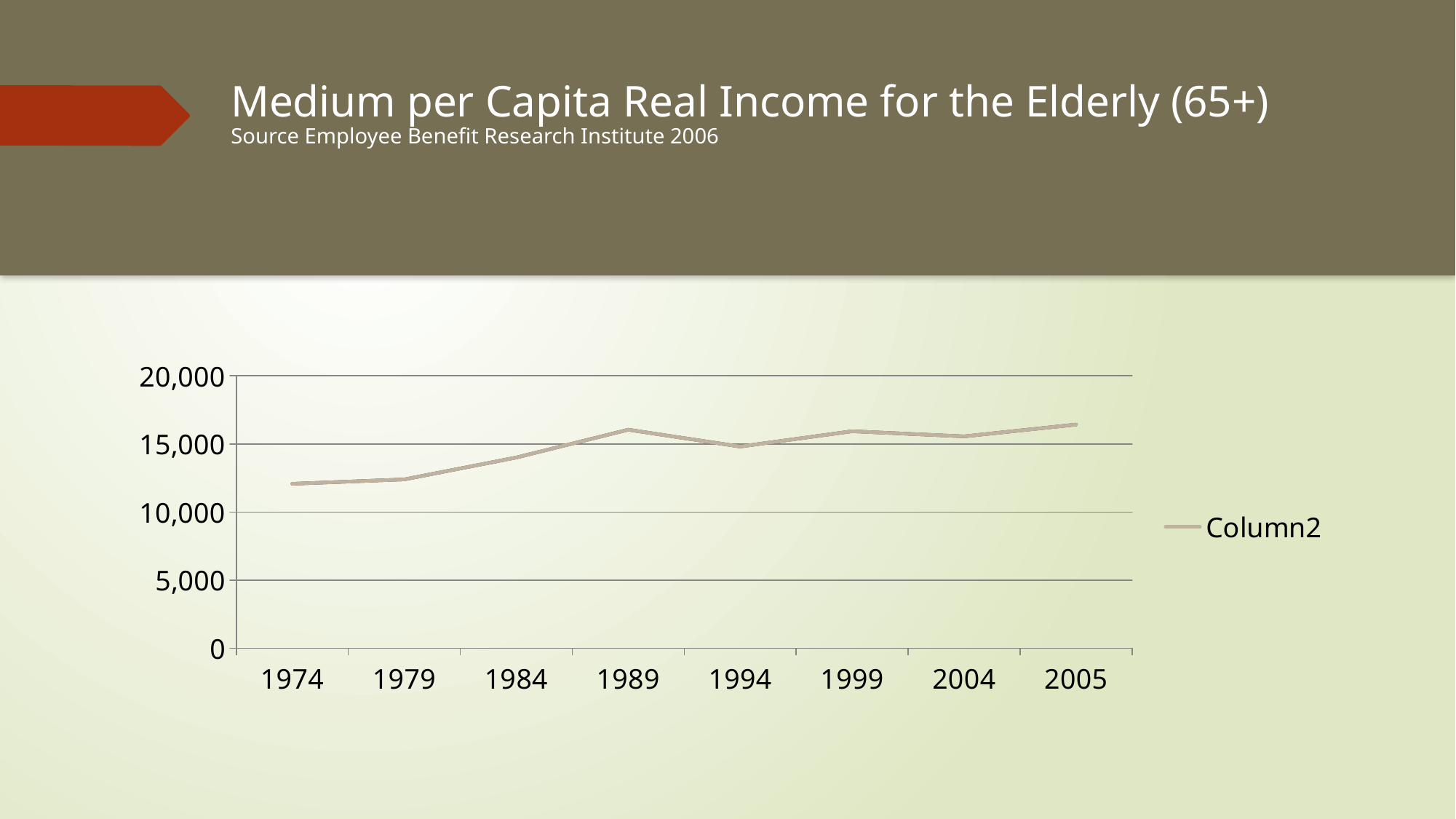
What is the name of the series shown in the legend? Column2 Overall, do the values rise or fall from 1974 to 2005? rise What kind of chart is shown on the slide? line chart Which year has the lowest value? 1974 What is the title of the chart on the slide? Medium per Capita Real Income for the Elderly (65+) Is the value for 1974 greater or less than 10,000? greater Is the value for 1984 greater or less than 15,000? less How many series does the legend list? 1 Which is larger, the value for 1989 or the value for 1994? 1989 How many years are plotted along the x axis? 8 Is the value for 1989 greater or less than 15,000? greater